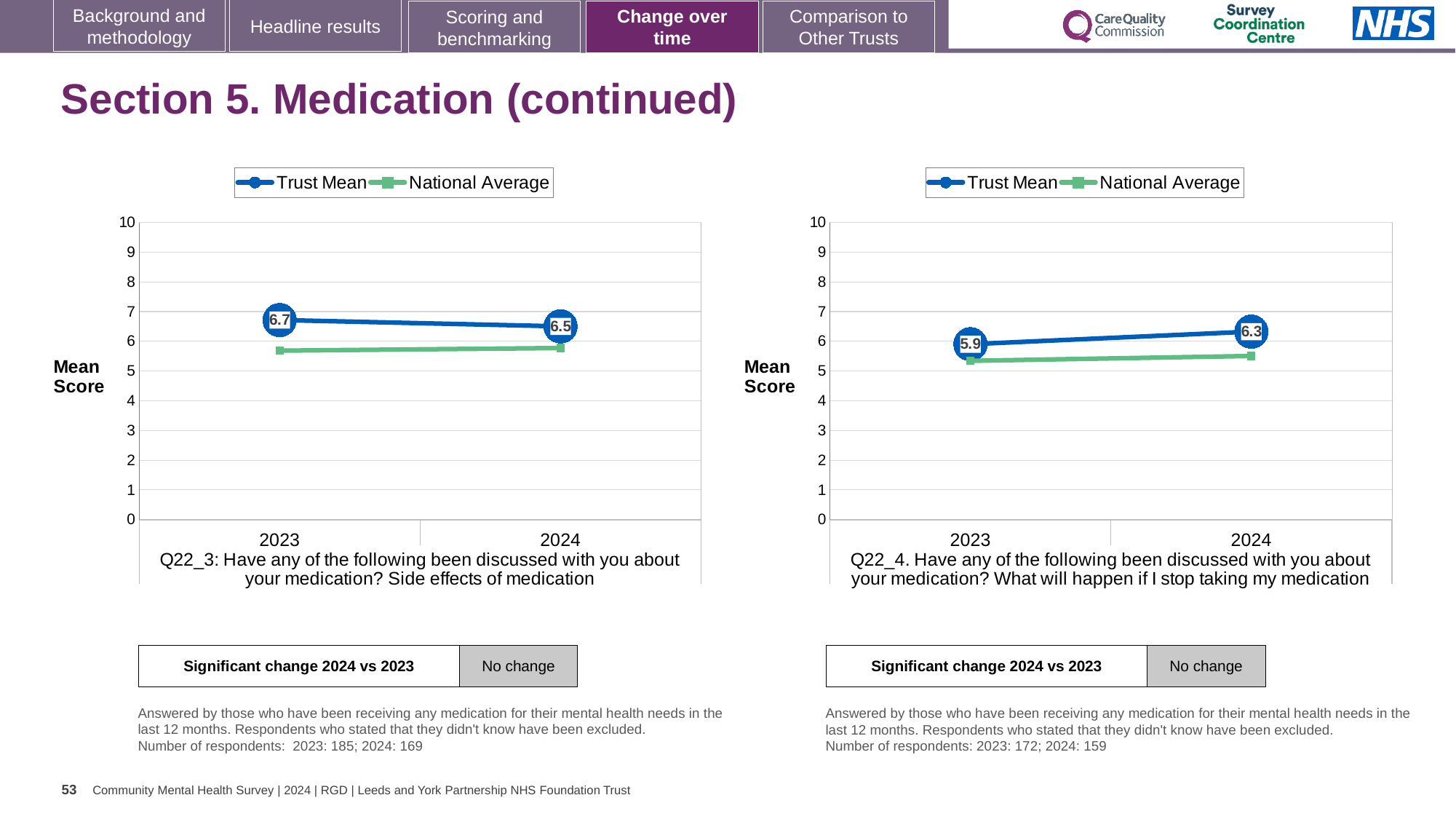
How many series does the legend of the left chart list? 2 In the left chart (Q22_3), what is the Trust Mean for 2023? 6.7 In the left chart (Q22_3), does the Trust Mean rise or fall from 2023 to 2024? fall In the left chart (Q22_3), what is the Trust Mean for 2024? 6.5 In the right chart (Q22_4), is the National Average for 2024 greater or less than 6? less In the right chart (Q22_4), by how much did the Trust Mean change from 2023 to 2024? 0.4 In the right chart (Q22_4), what is the Trust Mean for 2023? 5.9 In the right chart (Q22_4), what is the Trust Mean for 2024? 6.3 In the left chart (Q22_3), which year has the higher Trust Mean, 2023 or 2024? 2023 What kind of chart is used for Q22_4 on the right? line chart In the right chart (Q22_4), does the Trust Mean rise or fall from 2023 to 2024? rise In the left chart (Q22_3), is the National Average for 2023 greater or less than 6? less